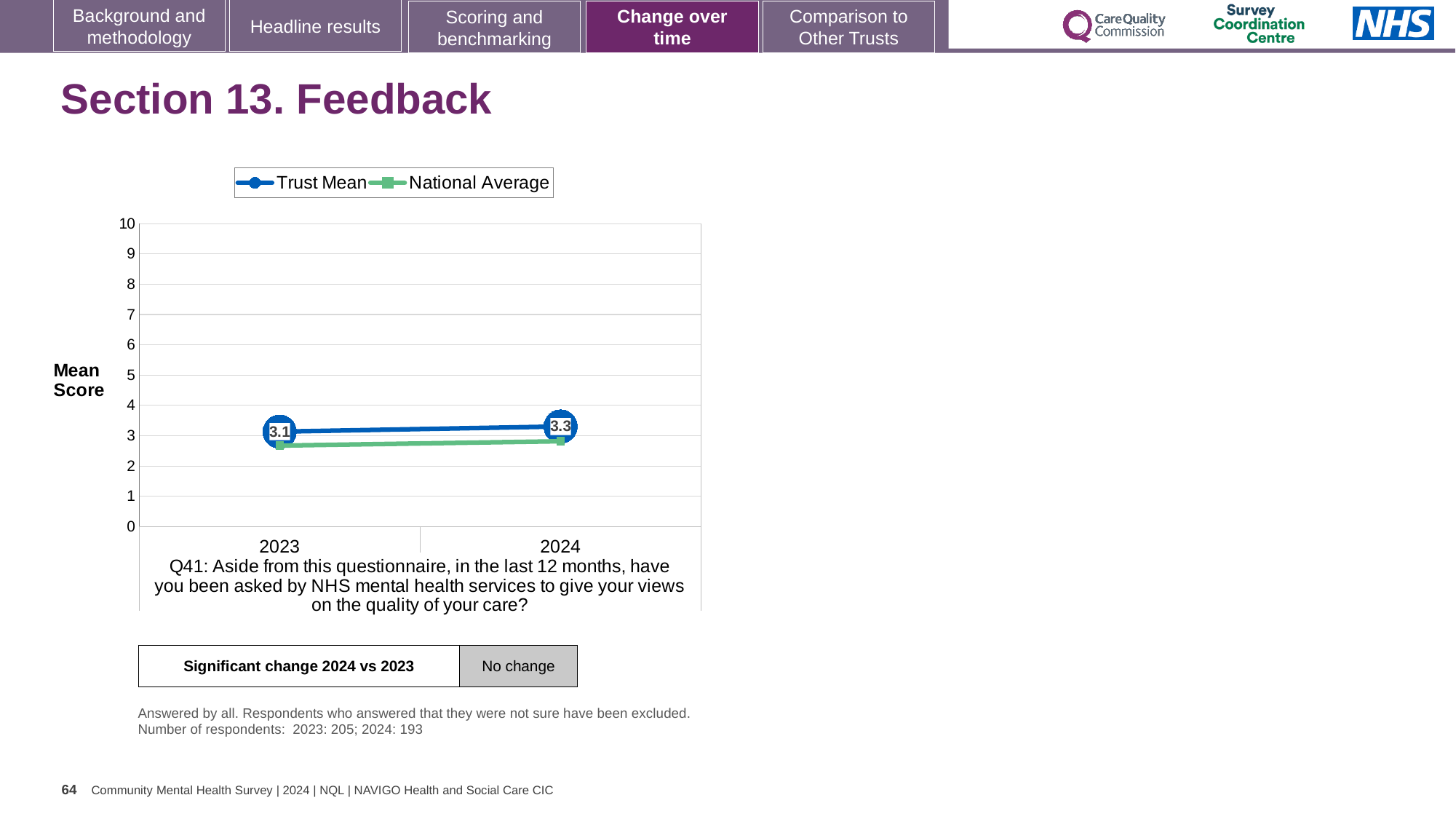
What is the Trust Mean score for 2023? 3.1 How many years are shown on the x axis of the chart? 2 Does the Trust Mean rise or fall from 2023 to 2024? rise Is the Trust Mean for 2024 greater or less than the Trust Mean for 2023? greater How many series does the legend list? 2 What is the Trust Mean score for 2024? 3.3 Which year has the higher Trust Mean score? 2024 What is the difference between the Trust Mean scores for 2024 and 2023? 0.2 Is the Trust Mean value for 2024 greater or less than 4? less Which year has the lower Trust Mean score? 2023 Is the National Average value for 2023 greater or less than 3? less What kind of chart is shown on the slide? line chart